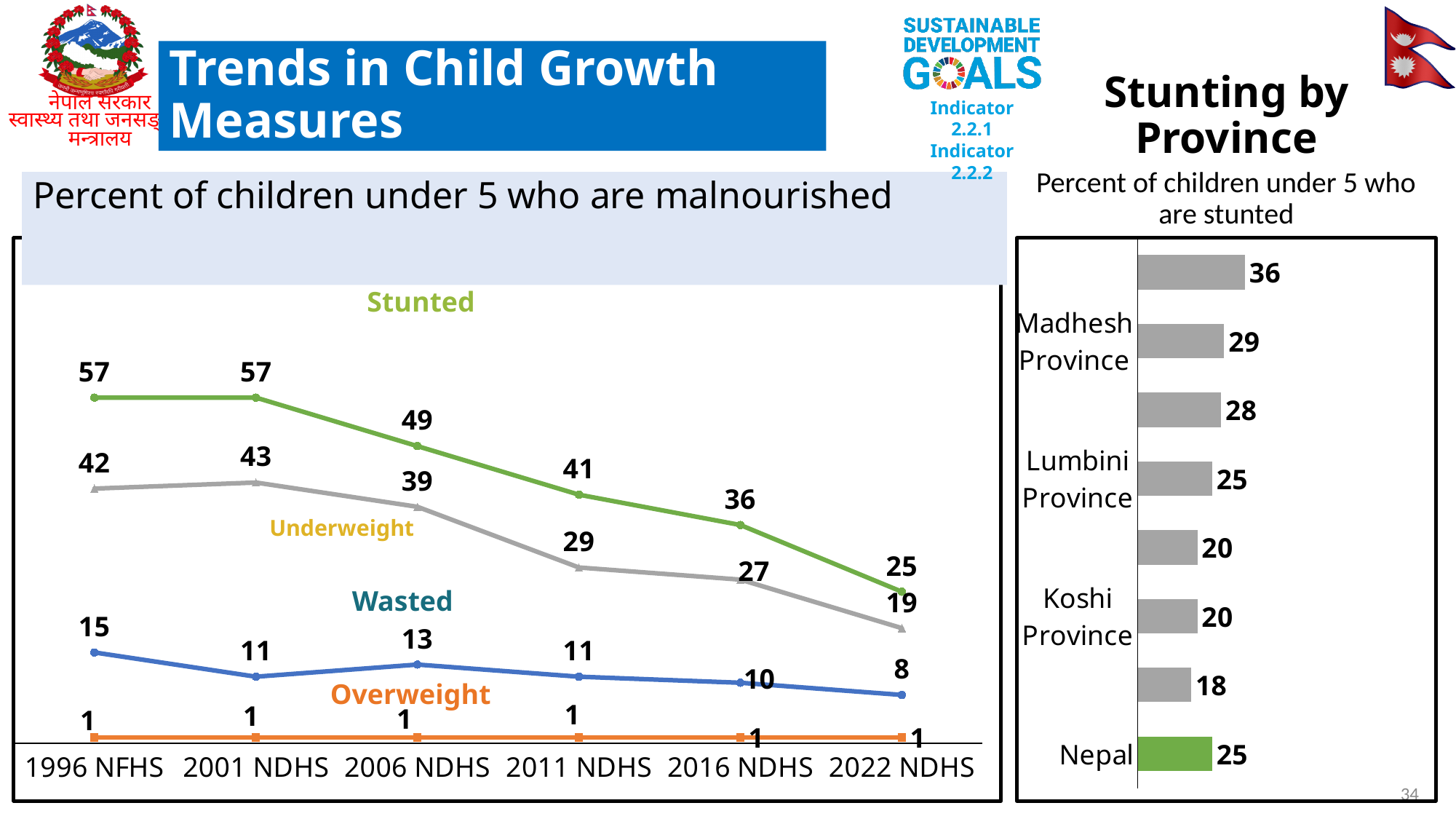
In the line chart 'Percent of children under 5 who are malnourished', does the Underweight line generally rise or fall from 1996 NFHS to 2022 NDHS? fall In the line chart 'Percent of children under 5 who are malnourished', what is the Underweight value for 2006 NDHS? 39 What kind of chart is 'Stunting by Province'? bar chart In the line chart 'Percent of children under 5 who are malnourished', by how much did the Stunted value fall between 1996 NFHS and 2022 NDHS? 32 In the line chart 'Percent of children under 5 who are malnourished', what is the Overweight value for 2016 NDHS? 1 In the line chart 'Percent of children under 5 who are malnourished', what is the Stunted value for 2022 NDHS? 25 In the line chart 'Percent of children under 5 who are malnourished', which is larger in 2011 NDHS: the Stunted value or the Underweight value? Stunted How many series are plotted in the line chart 'Percent of children under 5 who are malnourished'? 4 In the 'Stunting by Province' chart, what is the highest value shown on any bar? 36 How many survey years are shown on the x axis of the line chart 'Percent of children under 5 who are malnourished'? 6 In the 'Stunting by Province' chart, what is the value for Nepal? 25 In the line chart 'Percent of children under 5 who are malnourished', what is the Wasted value for 1996 NFHS? 15